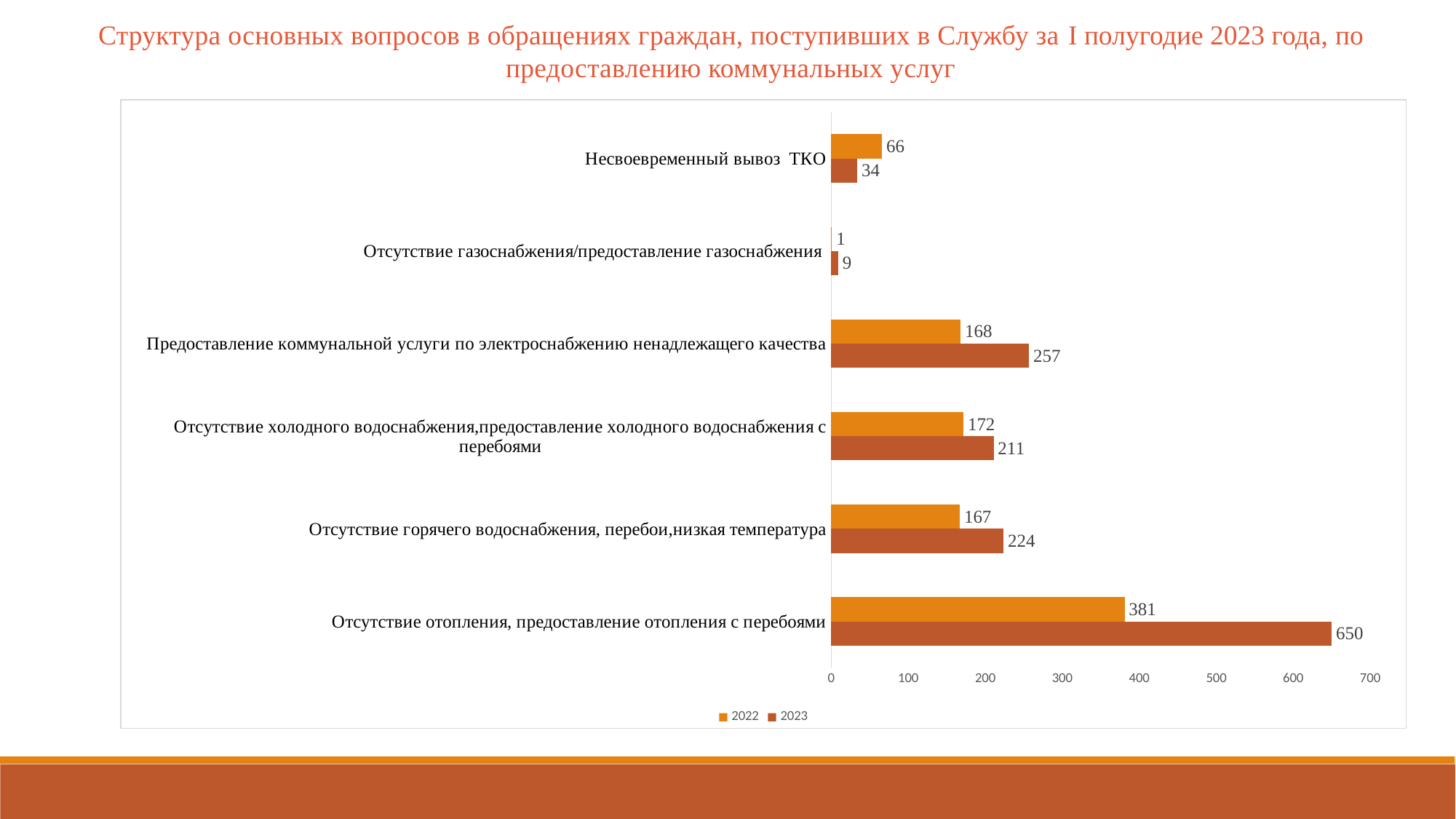
Is the 2023 value for "Отсутствие холодного водоснабжения,предоставление холодного водоснабжения с перебоями" greater or less than 200? greater What is the difference between the 2023 and 2022 values for "Отсутствие горячего водоснабжения, перебои,низкая температура"? 57 What is the difference between the 2023 and 2022 values for "Отсутствие отопления, предоставление отопления с перебоями"? 269 For "Несвоевременный вывоз ТКО", which year has the larger value, 2022 or 2023? 2022 Which category has the lowest 2022 value? Отсутствие газоснабжения/предоставление газоснабжения What is the 2023 value for "Предоставление коммунальной услуги по электроснабжению ненадлежащего качества"? 257 Which category has the highest 2023 value? Отсутствие отопления, предоставление отопления с перебоями What kind of chart is shown on the slide? Bar chart What is the 2022 value for "Несвоевременный вывоз ТКО"? 66 What is the 2023 value for "Отсутствие отопления, предоставление отопления с перебоями"? 650 How many categories are shown on the chart? 6 How many series does the legend list? 2